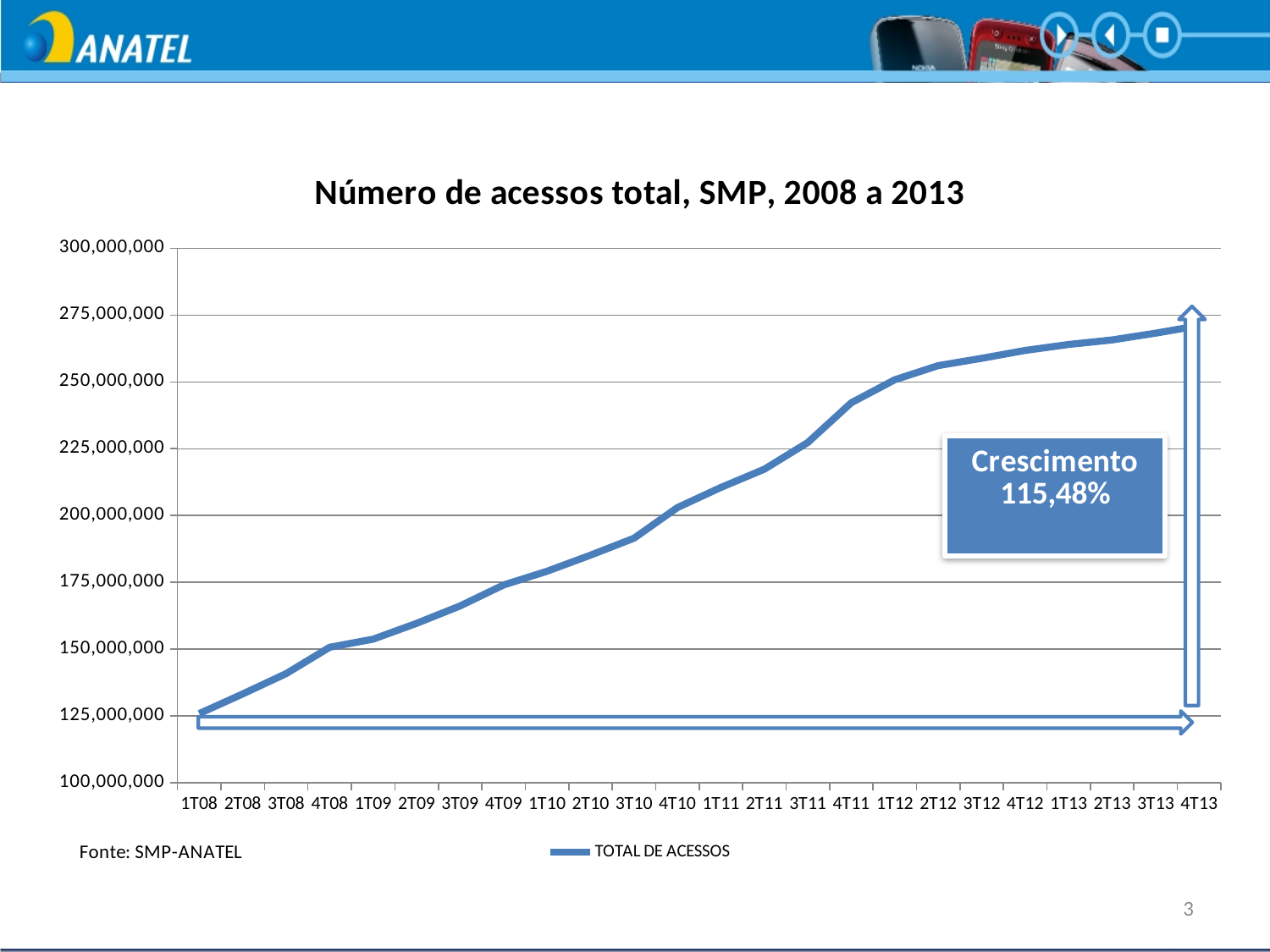
How many series does the legend list? 1 Is the value for 3T10 greater or less than 200,000,000? less Is the value for 4T13 greater or less than 250,000,000? greater How many quarters are plotted along the x axis? 24 What is the title of the chart? Número de acessos total, SMP, 2008 a 2013 Which quarter has the highest value? 4T13 Is the value for 4T11 greater or less than 225,000,000? greater What kind of chart is shown on the slide? line chart Which is larger, the value for 2T09 or the value for 2T12? 2T12 Which quarter has the lowest value? 1T08 Do the values rise or fall from 1T08 to 4T13? rise